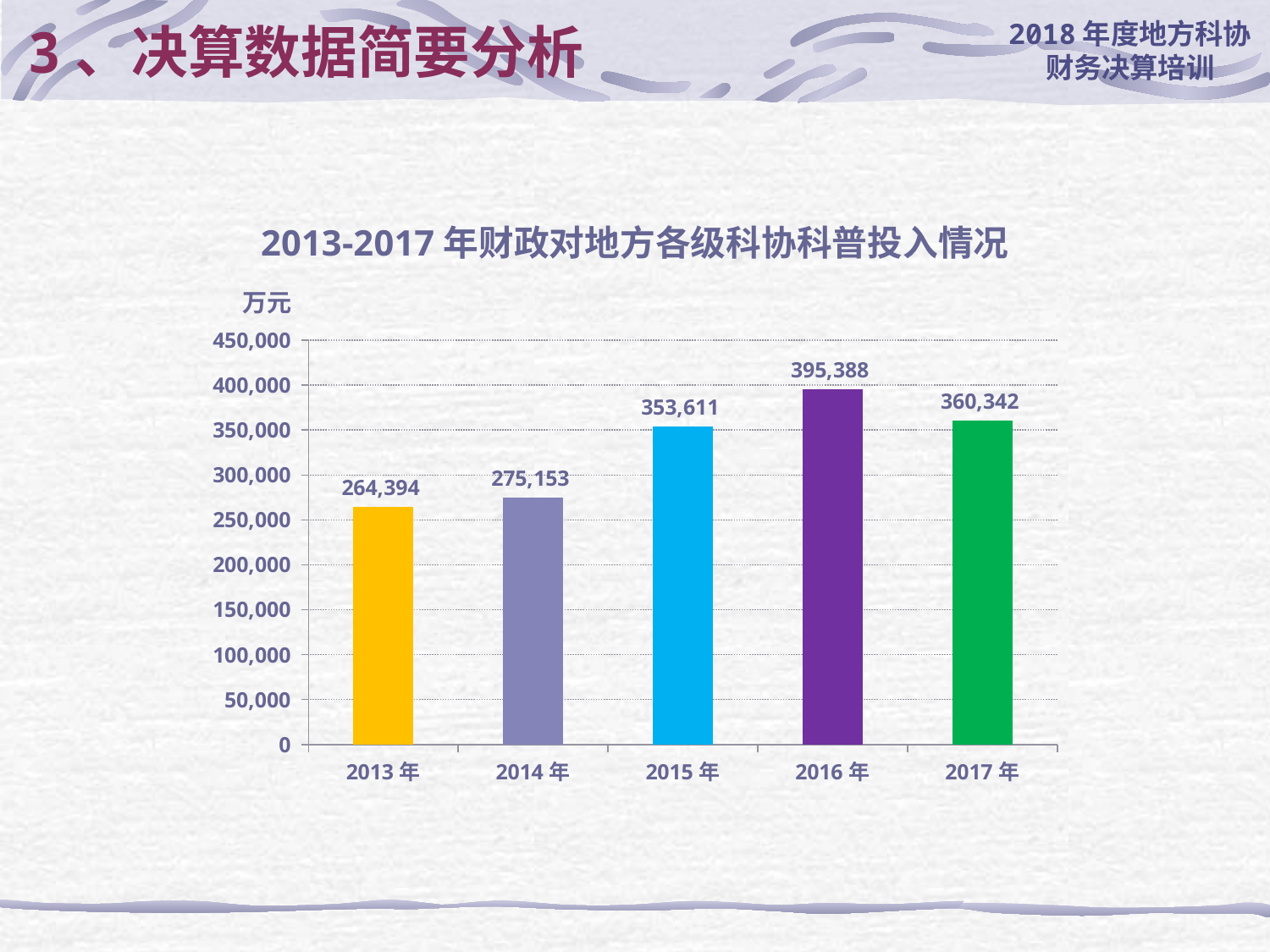
What kind of chart is shown on the slide? bar chart How many years are shown on the x axis? 5 Which is larger, the value for 2015年 or the value for 2017年? 2017年 Which year has the highest value? 2016年 Which year has the lowest value? 2013年 What is the value for 2016年? 395,388 What is the difference between the values for 2014年 and 2013年? 10,759 What unit is shown above the y axis? 万元 What is the value for 2013年? 264,394 What is the difference between the values for 2016年 and 2017年? 35,046 Is the value for 2015年 greater or less than 350,000? greater What is the value for 2017年? 360,342